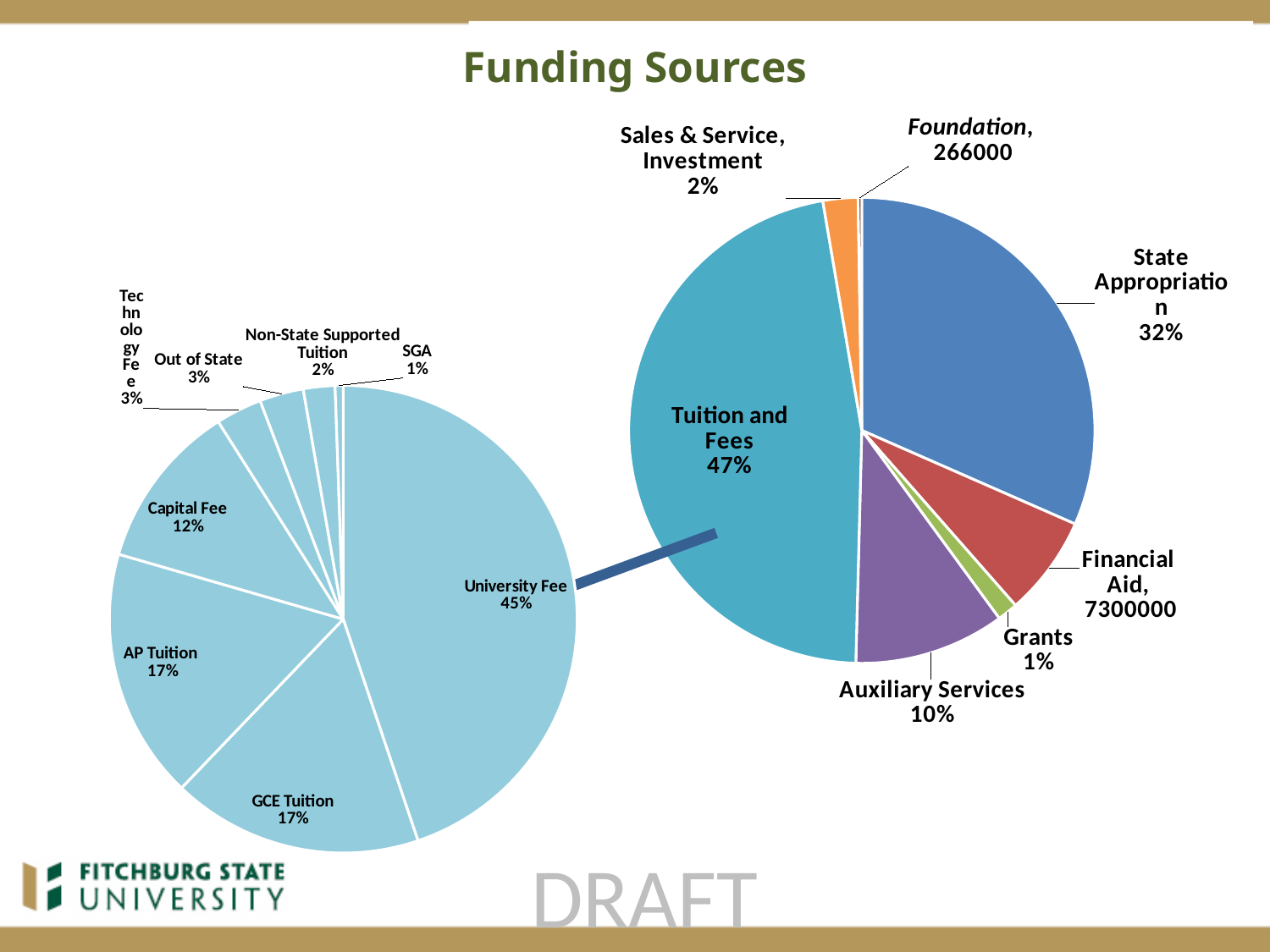
In the breakdown pie chart on the left, which category has the smallest share? SGA In the breakdown pie chart on the left, what share does Capital Fee account for? 12% In the main pie chart on the right, which is larger: Auxiliary Services or Sales & Service, Investment? Auxiliary Services How many slices does the breakdown pie chart on the left have? 8 In the main pie chart on the right, what share of funding comes from Tuition and Fees? 47% In the main pie chart on the right, which funding source has the largest share? Tuition and Fees In the breakdown pie chart on the left, what share does University Fee account for? 45% What type of chart is used on this slide? Pie chart In the main pie chart on the right, what value is shown for Financial Aid? 7300000 In the main pie chart on the right, what is the difference in percentage points between Tuition and Fees and State Appropriation? 15 percentage points In the main pie chart on the right, what share of funding comes from State Appropriation? 32% In the main pie chart on the right, what value is shown for Foundation? 266000